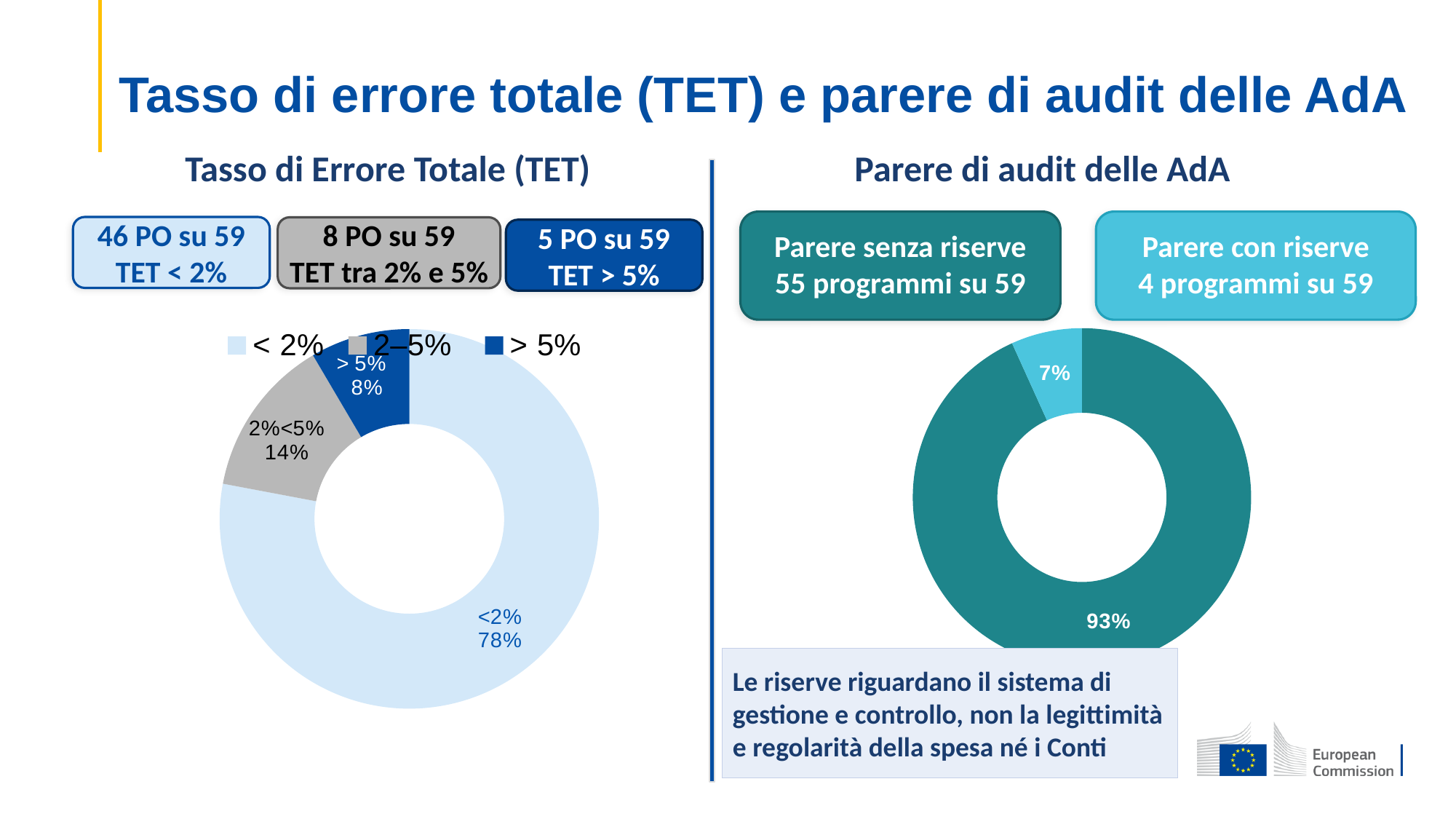
In the 'Tasso di Errore Totale (TET)' chart, which slice is the largest? <2% In the 'Tasso di Errore Totale (TET)' chart, what is the difference in percentage points between the '<2%' slice and the '2%<5%' slice? 64 In the 'Tasso di Errore Totale (TET)' chart, which slice is the smallest? > 5% In the 'Parere di audit delle AdA' chart, what is the difference in percentage points between the two slices? 86 In the 'Tasso di Errore Totale (TET)' chart, what share is shown for the '2%<5%' slice? 14% In the 'Tasso di Errore Totale (TET)' chart, what share is shown for the '> 5%' slice? 8% In the 'Parere di audit delle AdA' chart on the right, what share is shown for the larger slice? 93% In the 'Tasso di Errore Totale (TET)' chart, what share is shown for the '<2%' slice? 78% In the 'Parere di audit delle AdA' chart on the right, what share is shown for the smaller slice? 7% How many entries does the legend of the 'Tasso di Errore Totale (TET)' chart list? 3 How many slices does the 'Tasso di Errore Totale (TET)' chart have? 3 What kind of chart is the 'Tasso di Errore Totale (TET)' chart on the left? Doughnut chart